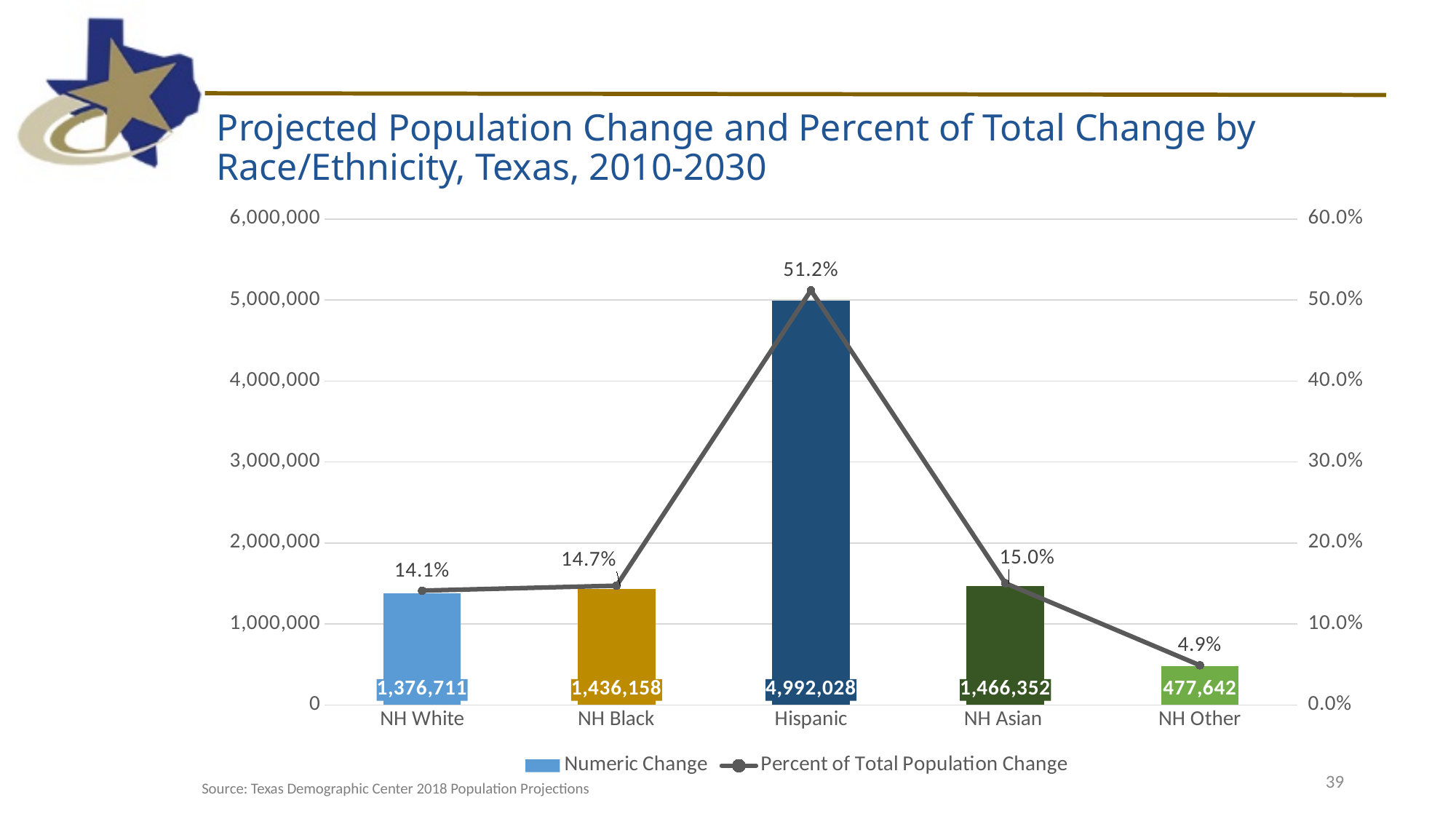
How many series does the legend list? 2 What is the Percent of Total Population Change for NH White? 14.1% Which has a larger Numeric Change, NH White or NH Black? NH Black What is the Numeric Change for Hispanic? 4,992,028 Is the Numeric Change for Hispanic greater or less than 4,000,000? greater What kind of chart is used to show the Numeric Change series? Bar chart Which race/ethnicity group has the lowest Percent of Total Population Change? NH Other What is the Percent of Total Population Change for NH Asian? 15.0% How many race/ethnicity categories are shown on the x axis? 5 Which race/ethnicity group has the highest Numeric Change? Hispanic What is the difference in Numeric Change between NH Asian and NH Black? 30,194 What is the Numeric Change for NH Other? 477,642